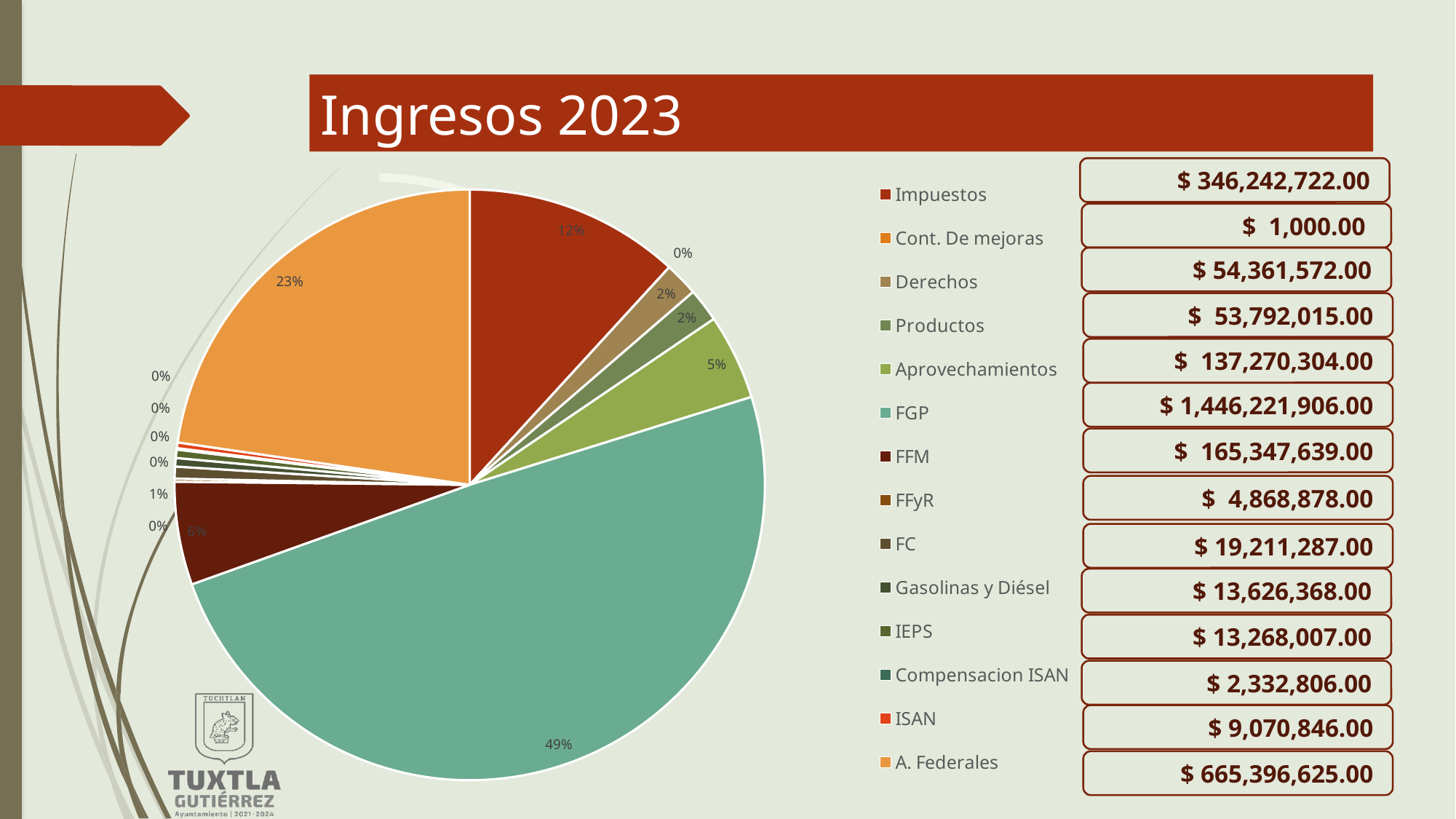
What is the title of the slide containing the chart? Ingresos 2023 What is the value shown for Cont. De mejoras? $ 1,000.00 What share of the pie does FGP represent? 49% What share of the pie does Impuestos represent? 12% Which slice is larger, A. Federales or Impuestos? A. Federales What share of the pie does A. Federales represent? 23% Which category has the largest slice of the pie? FGP What type of chart is shown on the slide? pie chart How many categories does the legend list? 14 What is the value shown for FGP? $ 1,446,221,906.00